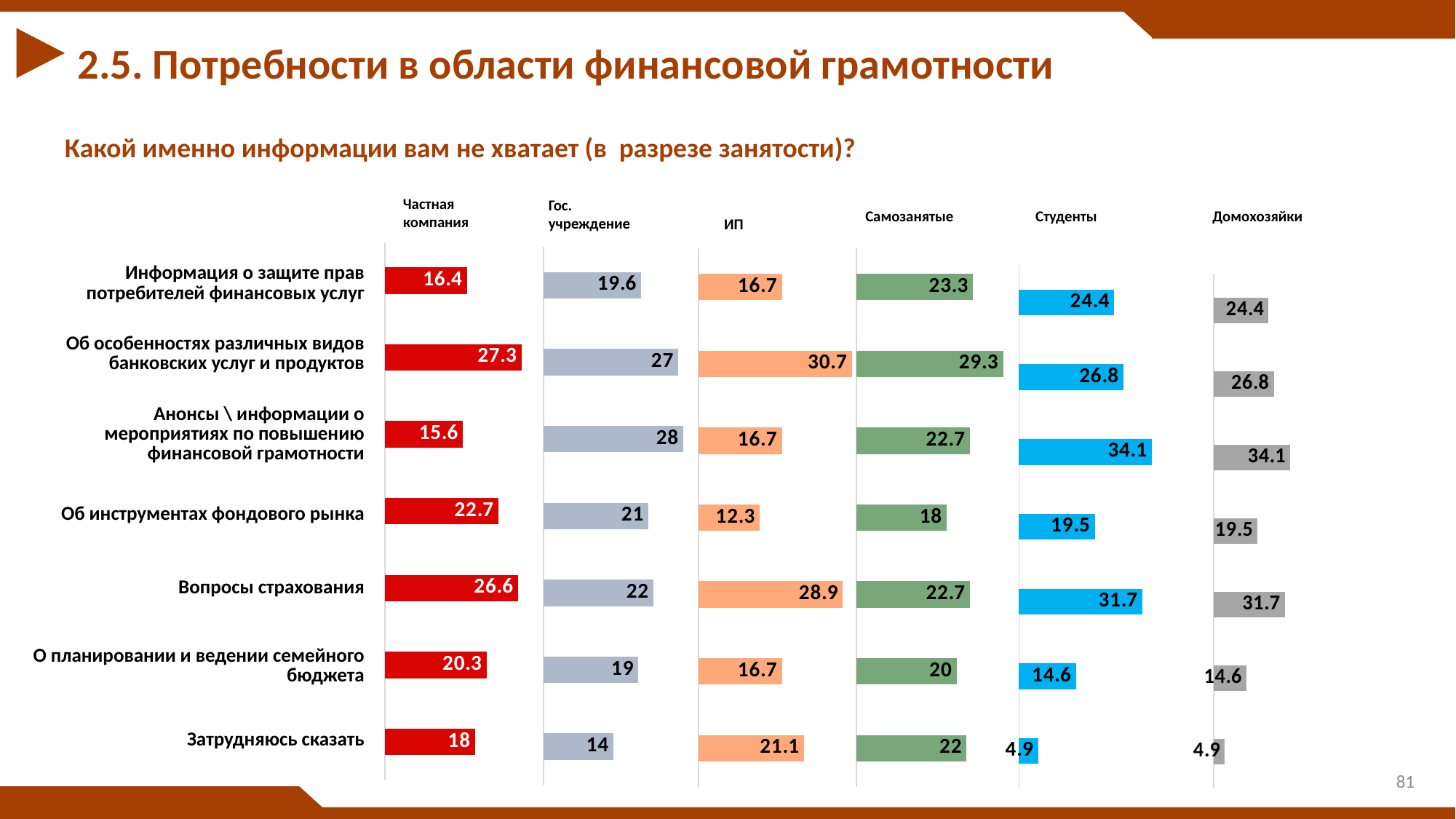
For Гос. учреждение, which category has the highest value? Анонсы \ информации о мероприятиях по повышению финансовой грамотности What is the value for Частная компания in the category 'Об особенностях различных видов банковских услуг и продуктов'? 27.3 For Студенты, what is the difference between the value for 'Анонсы \ информации о мероприятиях по повышению финансовой грамотности' and 'Затрудняюсь сказать'? 29.2 For Студенты, which category has the highest value? Анонсы \ информации о мероприятиях по повышению финансовой грамотности How many information categories are listed on the chart? 7 How many employment groups are shown on the chart? 6 In the category 'Вопросы страхования', which is larger: Частная компания or Гос. учреждение? Частная компания What is the value for Домохозяйки in the category 'Анонсы \ информации о мероприятиях по повышению финансовой грамотности'? 34.1 For ИП, which category has the lowest value? Об инструментах фондового рынка What is the value for Студенты in the category 'Затрудняюсь сказать'? 4.9 For Самозанятые, what is the difference between 'Об особенностях различных видов банковских услуг и продуктов' and 'Об инструментах фондового рынка'? 11.3 What is the value for ИП in the category 'Вопросы страхования'? 28.9